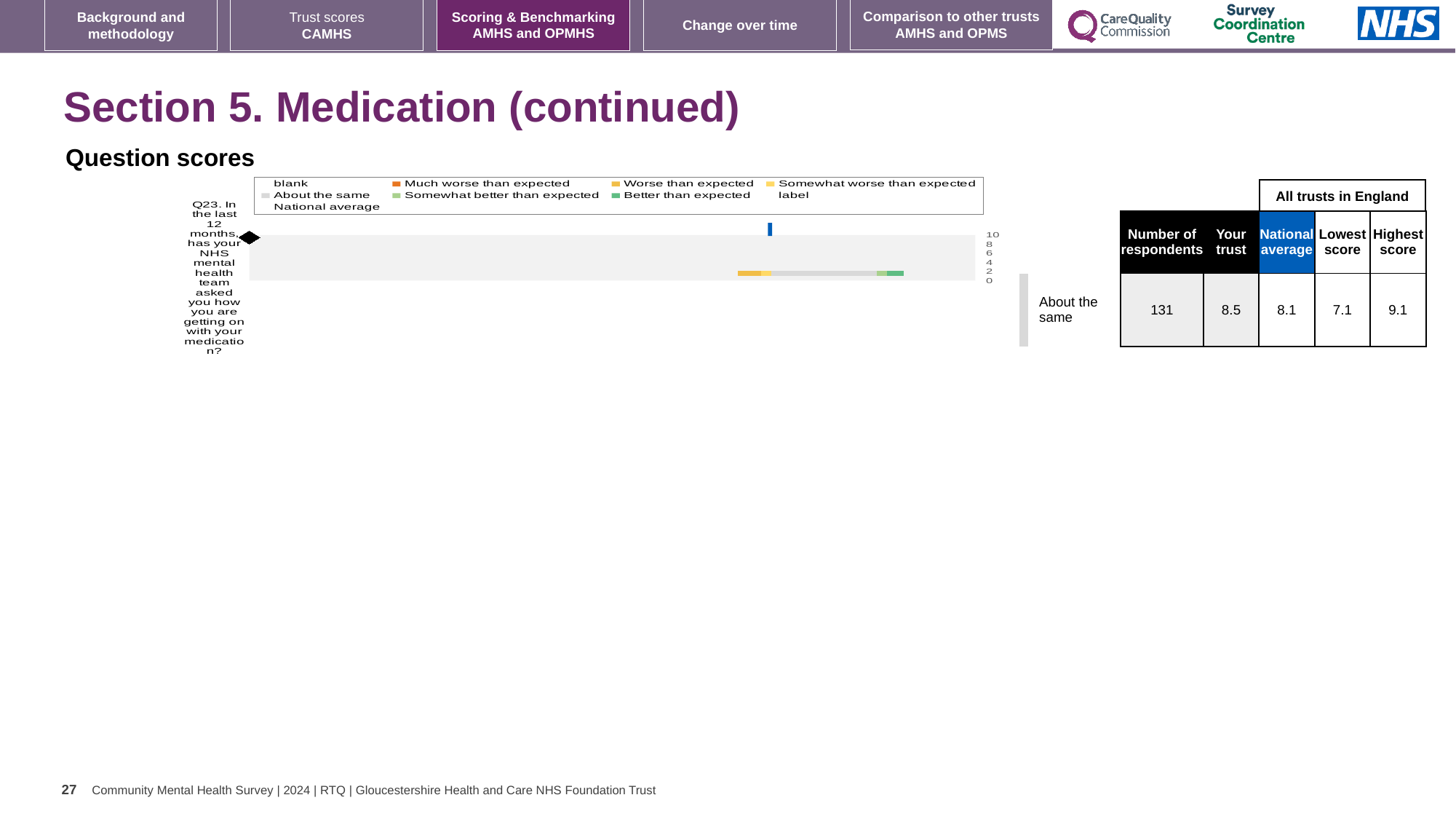
Which question is plotted in the chart? Q23. In the last 12 months, has your NHS mental health team asked you how you are getting on with your medication? Which legend entry is shown in orange? Much worse than expected What kind of chart is shown on the slide? bar chart What is the highest value shown on the chart's axis? 10 How many questions (categories) are plotted in the chart? 1 Which benchmark category is shown next to the bar for Q23? About the same